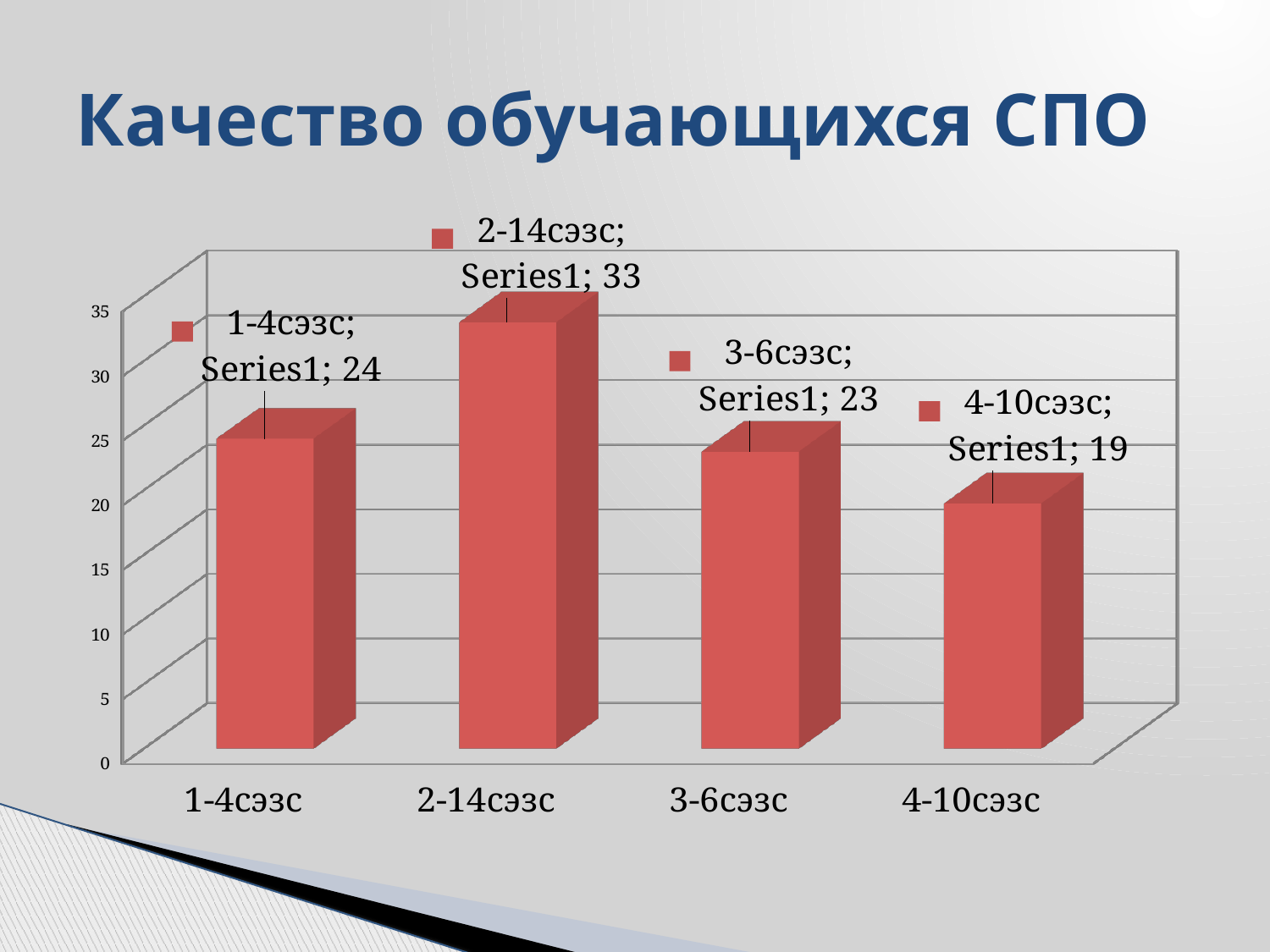
What is the difference between the values for 1-4сэзс and 3-6сэзс? 1 What is the value for 2-14сэзс? 33 What kind of chart is shown on the slide? bar chart What is the value for 1-4сэзс? 24 Which category has the highest value? 2-14сэзс What is the value for 4-10сэзс? 19 How many categories are shown on the x axis? 4 What is the difference between the values for 2-14сэзс and 4-10сэзс? 14 Which is larger, the value for 1-4сэзс or the value for 4-10сэзс? 1-4сэзс What is the title of the slide? Качество обучающихся СПО Which category has the lowest value? 4-10сэзс What is the value for 3-6сэзс? 23